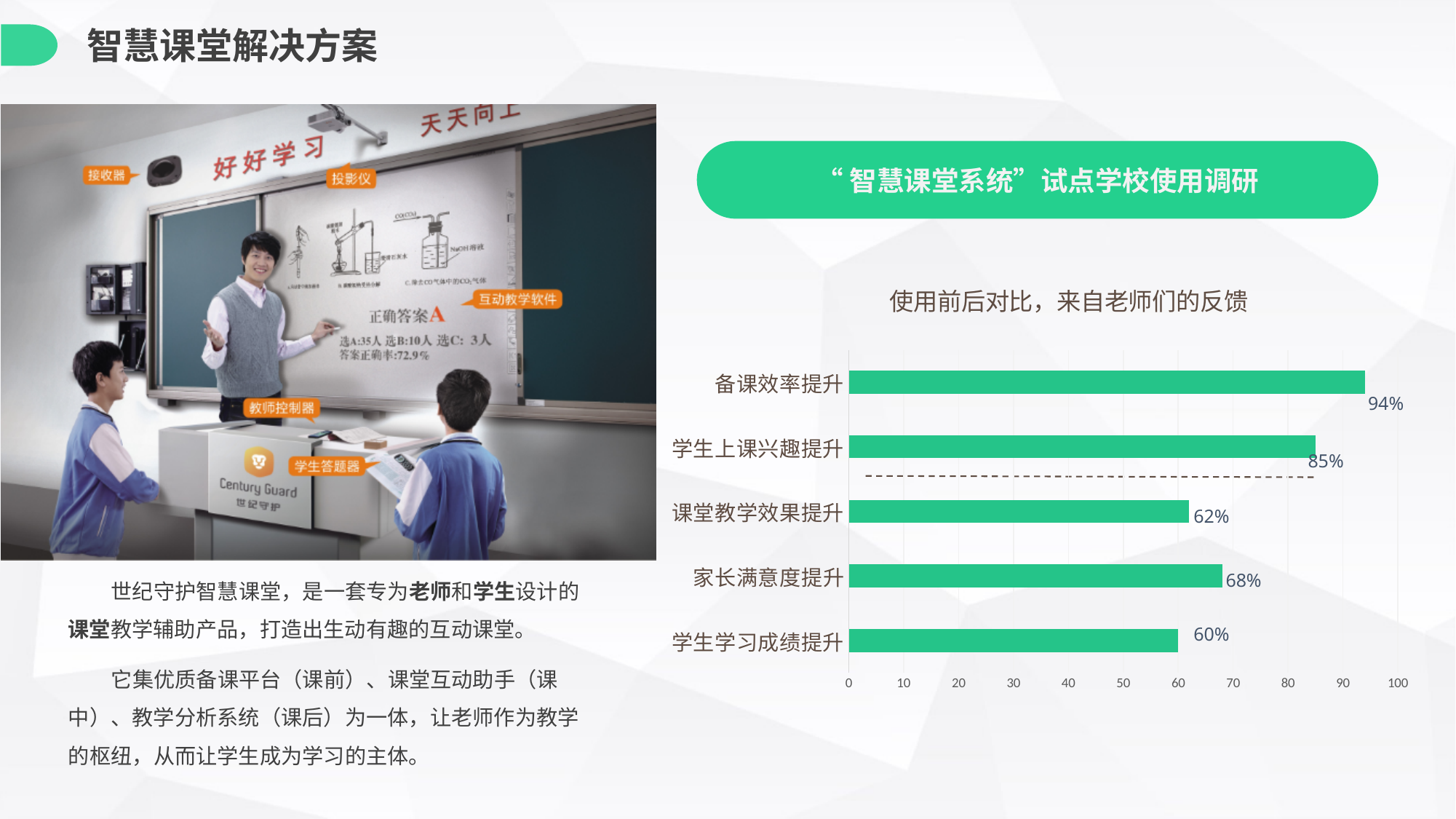
Which category has the highest value? 备课效率提升 Which is larger, the value for 家长满意度提升 or the value for 课堂教学效果提升? 家长满意度提升 What is the title of the chart? 使用前后对比，来自老师们的反馈 What is the value for 备课效率提升? 94% What is the value for 学生学习成绩提升? 60% What is the value for 学生上课兴趣提升? 85% What is the value for 课堂教学效果提升? 62% What is the value for 家长满意度提升? 68% What is the difference between the values for 备课效率提升 and 学生上课兴趣提升? 9% What kind of chart is shown on the slide? bar chart Which category has the lowest value? 学生学习成绩提升 How many categories are shown in the chart? 5